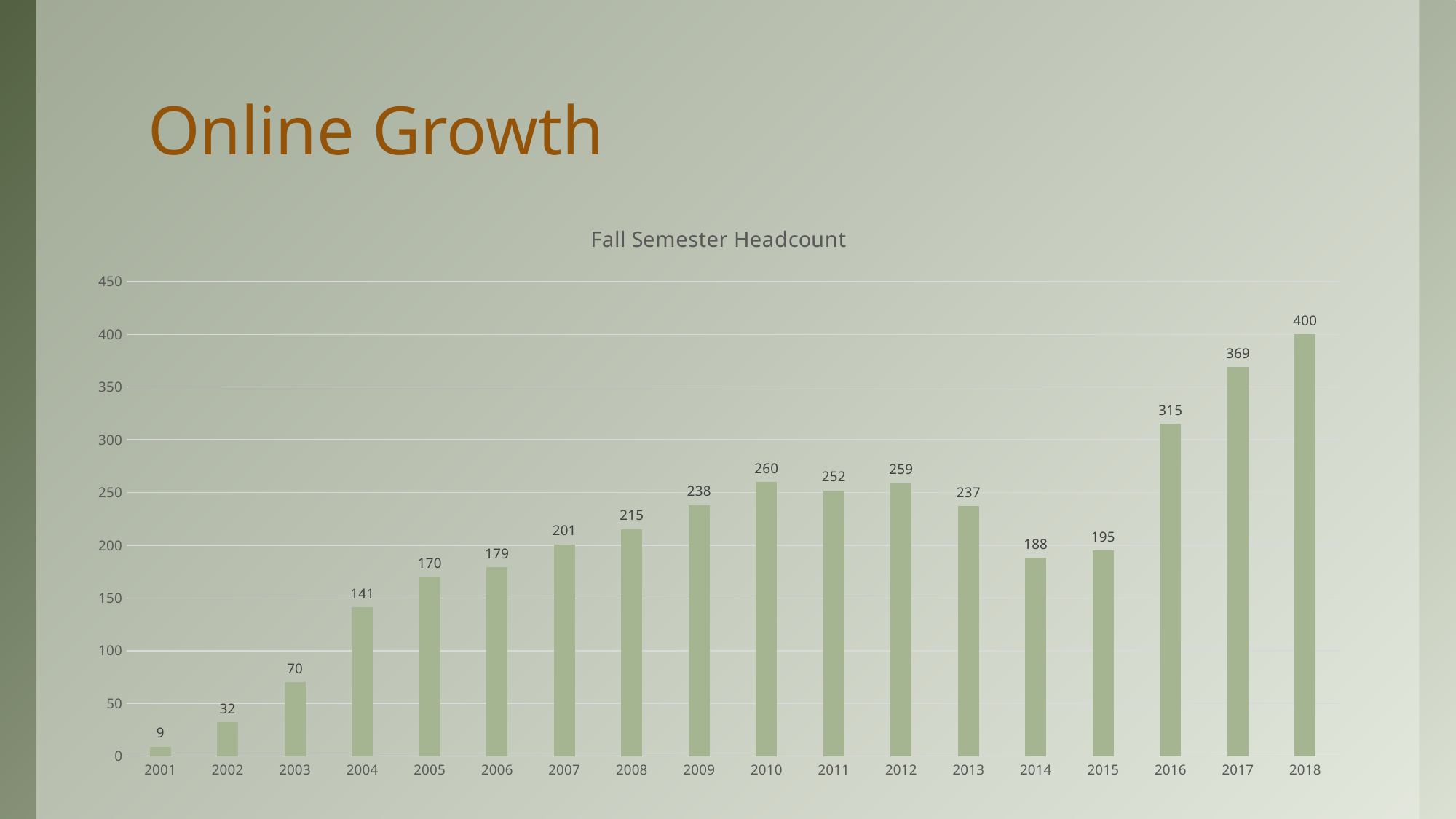
What kind of chart is shown on the slide? Bar chart Which year has the lowest Fall Semester Headcount? 2001 What is the difference between the headcount in 2018 and the headcount in 2017? 31 Which year has the highest Fall Semester Headcount? 2018 Is the headcount for 2009 greater or less than 200? greater What is the Fall Semester Headcount for 2001? 9 Which year has a larger headcount, 2012 or 2015? 2012 What is the Fall Semester Headcount for 2010? 260 What is the difference between the headcount in 2013 and the headcount in 2014? 49 How many years are shown on the x axis of the chart? 18 What is the title of the chart? Fall Semester Headcount What is the Fall Semester Headcount for 2016? 315